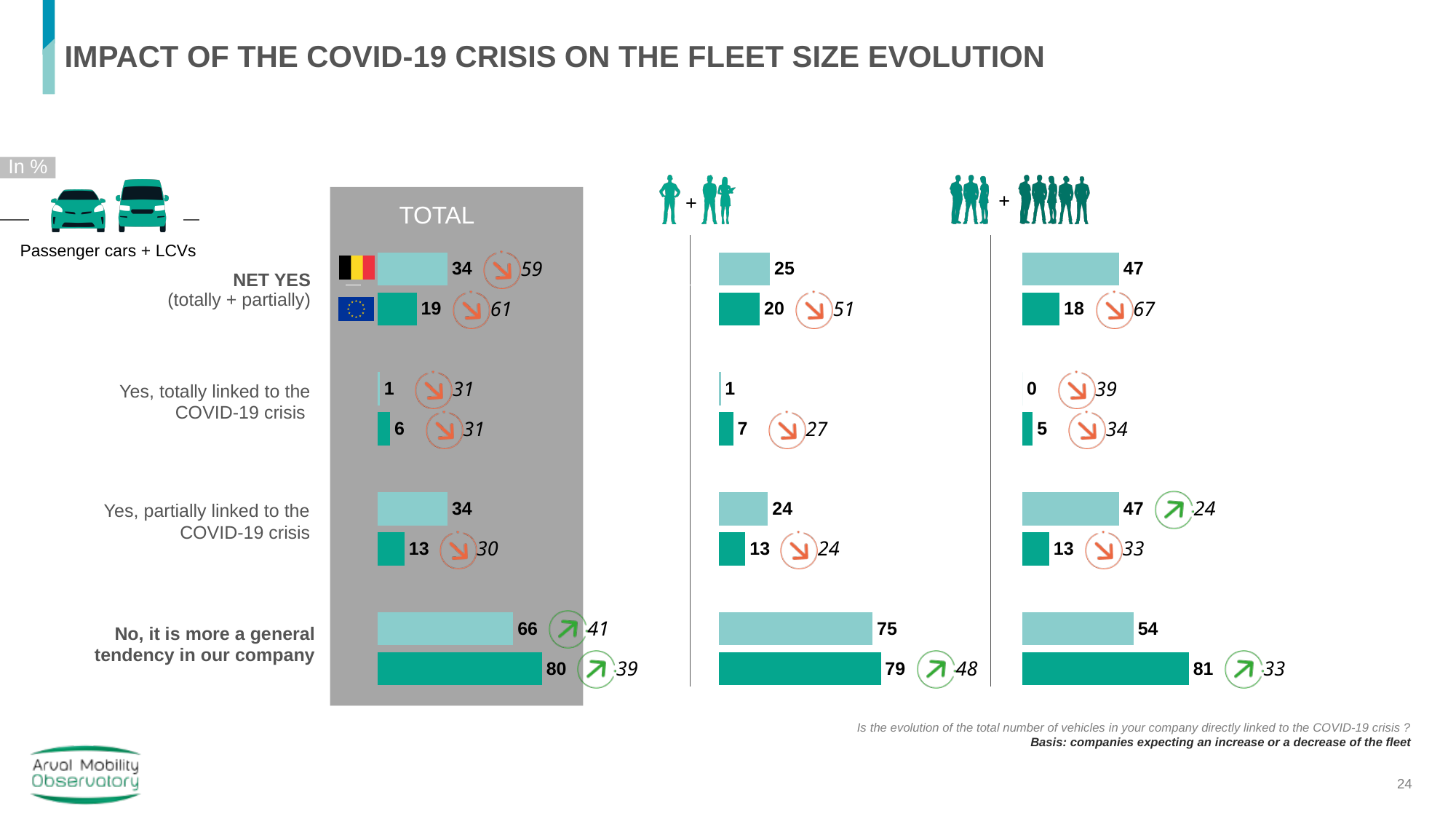
In the TOTAL chart, what is the Belgium value for NET YES (totally + partially)? 34 In the right-hand chart (larger companies), what is the Belgium value for 'Yes, partially linked to the COVID-19 crisis'? 47 In the right-hand chart (larger companies), what is the difference between the Belgium and Europe values for NET YES? 29 In the middle chart (smaller companies), which is larger for 'Yes, totally linked to the COVID-19 crisis': the Belgium value or the Europe value? Europe In the TOTAL chart, which category has the highest Belgium value? No, it is more a general tendency in our company How many response categories are shown in the TOTAL chart? 4 In the TOTAL chart, what is the difference between the Europe and Belgium values for 'No, it is more a general tendency in our company'? 14 In the right-hand chart (larger companies), which category has the lowest Belgium value? Yes, totally linked to the COVID-19 crisis In the TOTAL chart, what is the Europe value for 'No, it is more a general tendency in our company'? 80 In the middle chart (smaller companies), what is the Belgium value for 'No, it is more a general tendency in our company'? 75 In the right-hand chart (larger companies), what is the Europe value for NET YES? 18 What type of chart is used on this slide? Bar chart